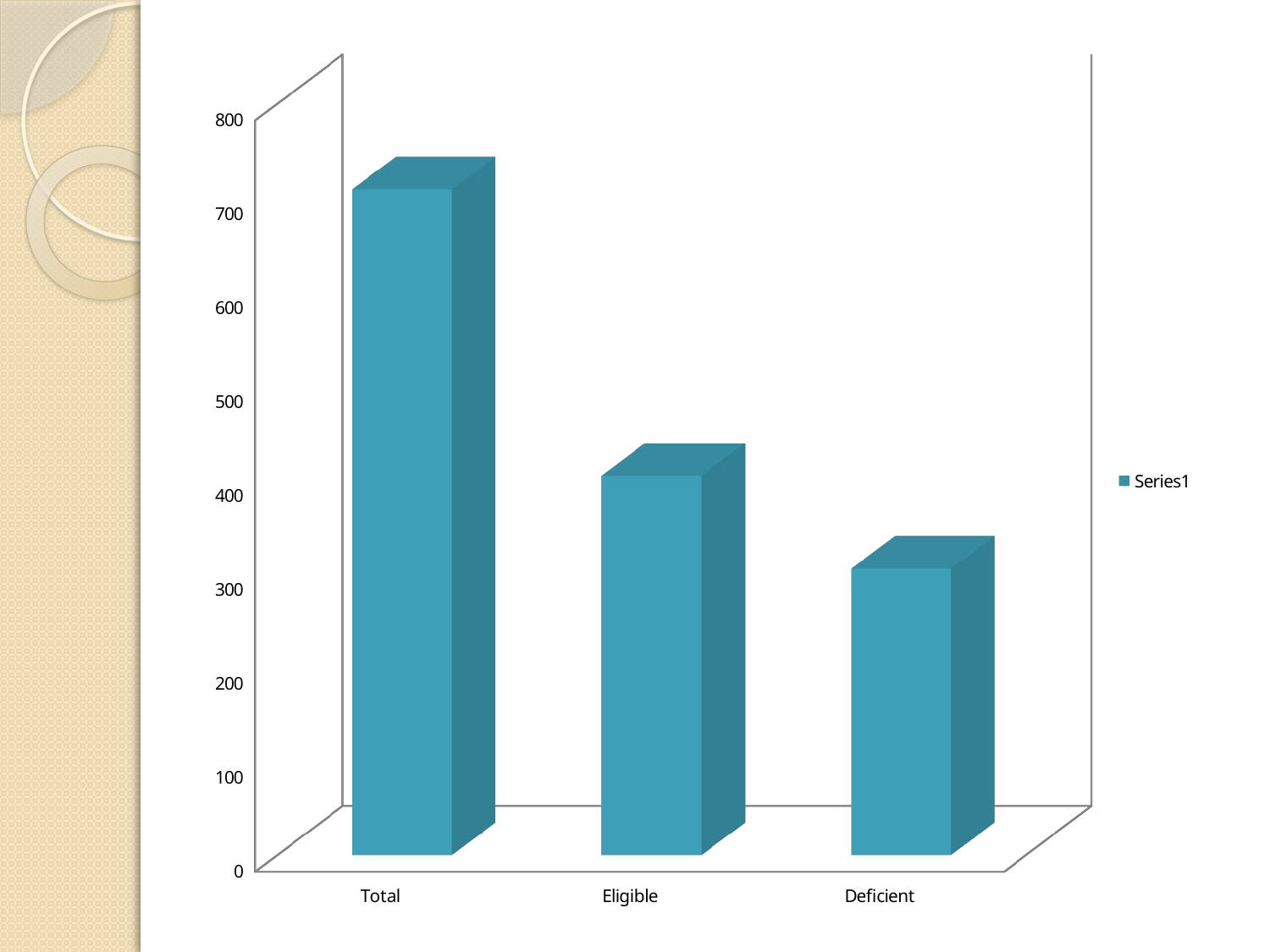
Which is larger, the value for Total or the value for Eligible? Total Is the value for Total greater or less than 600? greater How many series does the chart's legend list? 1 Is the value for Deficient greater or less than 200? greater What is the name of the series shown in the chart's legend? Series1 Which is larger, the value for Eligible or the value for Deficient? Eligible Which category has the lowest bar in the chart? Deficient Which category has the highest bar in the chart? Total What kind of chart is shown on the slide? bar chart Do the bar values rise or fall from left to right along the x axis? fall How many categories are shown on the x axis of the chart? 3 Is the value for Eligible greater or less than 600? less